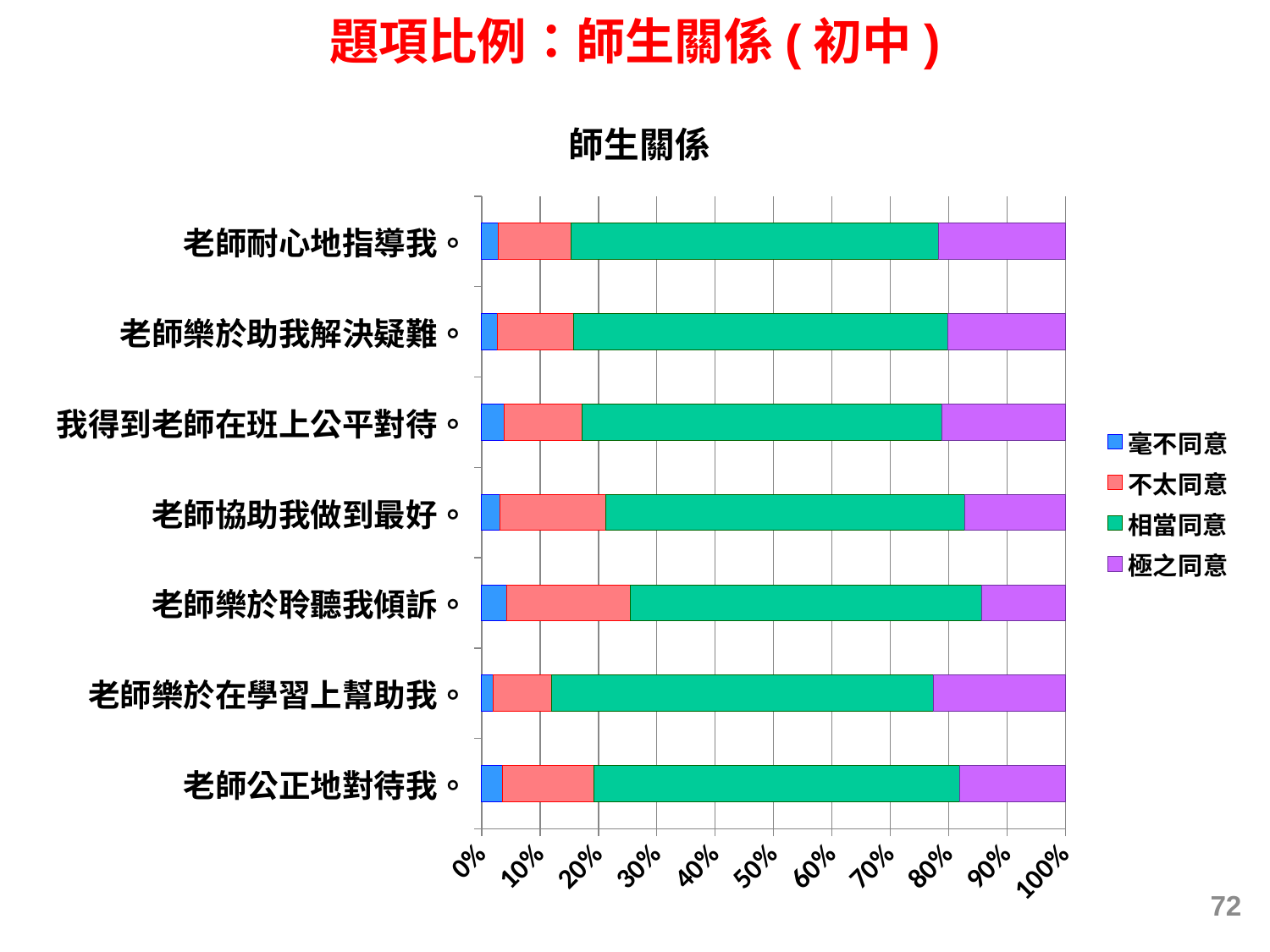
How many statements (categories) are plotted on the chart? 7 How many series does the legend list? 4 What kind of chart is shown on the slide? Stacked bar chart What is the total of each stacked bar on the chart? 100% Which legend entry is shown in green? 相當同意 Is the 極之同意 share for 老師樂於在學習上幫助我 greater or less than 30%? less Which statement has the largest 不太同意 share? 老師樂於聆聽我傾訴 What is the title of the chart? 師生關係 Is the 不太同意 share for 老師協助我做到最好 greater or less than 10%? greater Which has the larger 不太同意 share: 老師樂於聆聽我傾訴 or 老師樂於在學習上幫助我? 老師樂於聆聽我傾訴 Is the 極之同意 share for 老師樂於聆聽我傾訴 greater or less than 20%? less